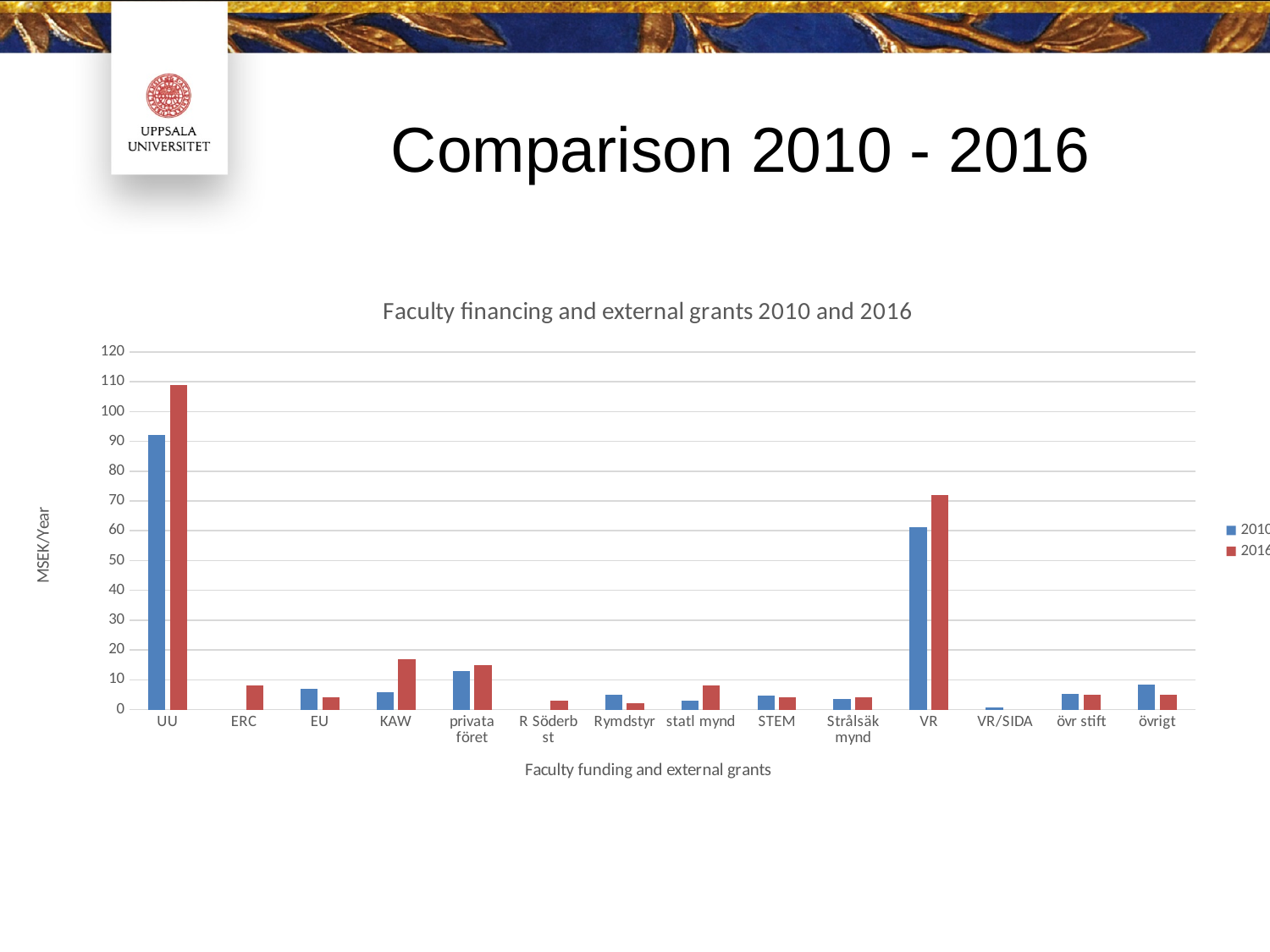
Which has the larger 2010 value, UU or VR? UU Is the 2016 value for UU greater or less than 100? greater Is the 2016 value for VR greater or less than 60? greater For EU, which series has the larger value, 2010 or 2016? 2010 How many series does the legend list? 2 What is the label on the vertical axis? MSEK/Year Which category has the highest value for 2016? UU For KAW, which series has the larger value, 2010 or 2016? 2016 How many categories are shown along the x axis? 14 What kind of chart is shown on the slide? bar chart Is the 2010 value for VR greater or less than 70? less Which category has the highest value for 2010? UU